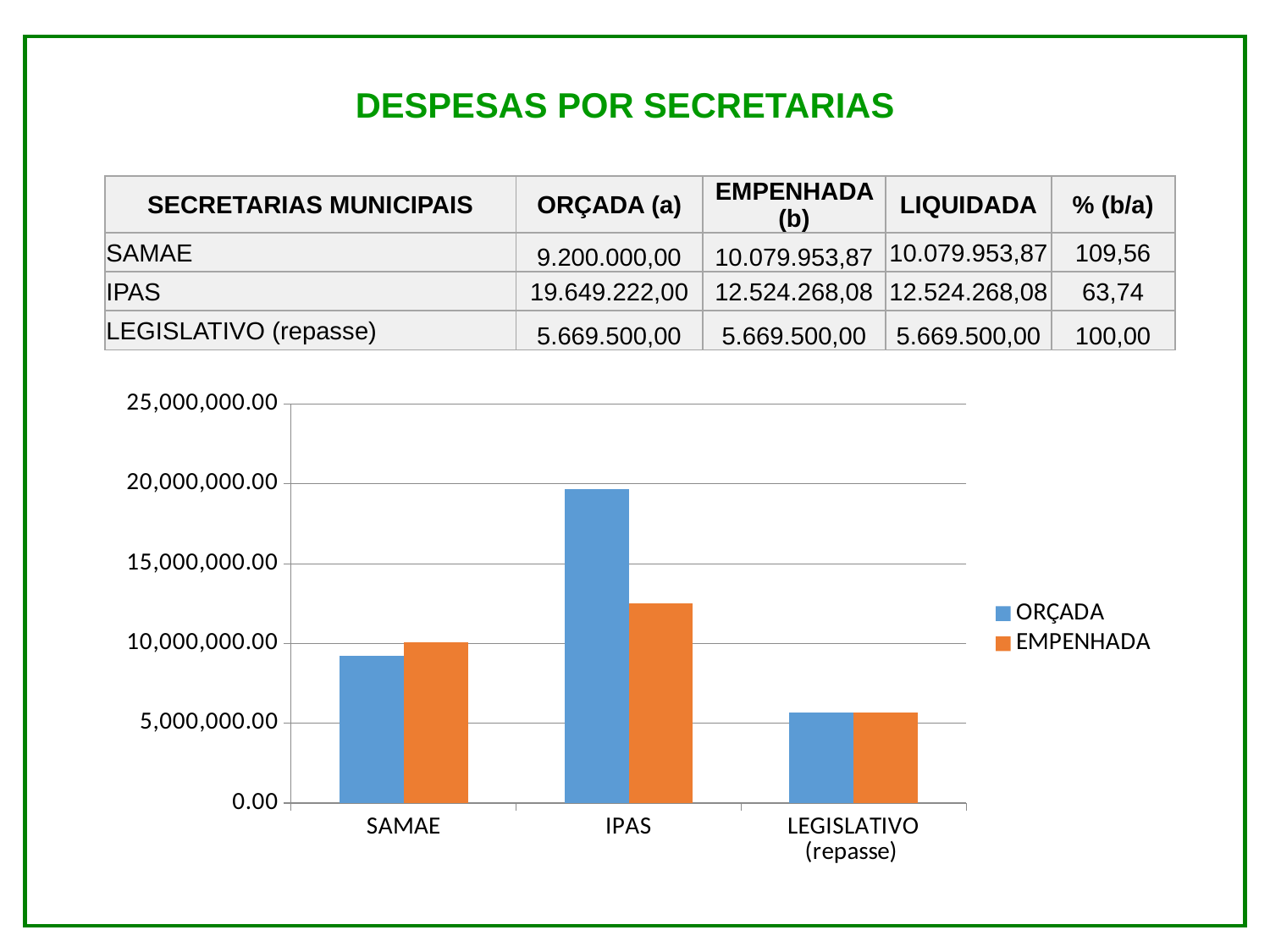
How many categories are shown on the x axis of the chart? 3 What kind of chart is shown on the slide? bar chart According to the table on the slide, what is the EMPENHADA (b) value for SAMAE? 10.079.953,87 Is the ORÇADA value for IPAS in the chart greater or less than 15,000,000.00? greater What colour are the ORÇADA bars in the chart? blue How many series does the chart's legend list? 2 Is the EMPENHADA value for LEGISLATIVO (repasse) in the chart greater or less than 10,000,000.00? less Which category has the lowest ORÇADA bar in the chart? LEGISLATIVO (repasse) According to the table on the slide, what is the ORÇADA (a) value for IPAS? 19.649.222,00 Which category has the highest ORÇADA bar in the chart? IPAS Using the values in the table, what is the difference between the ORÇADA and EMPENHADA values for IPAS? 7.124.953,92 For SAMAE, which bar is taller in the chart, ORÇADA or EMPENHADA? EMPENHADA